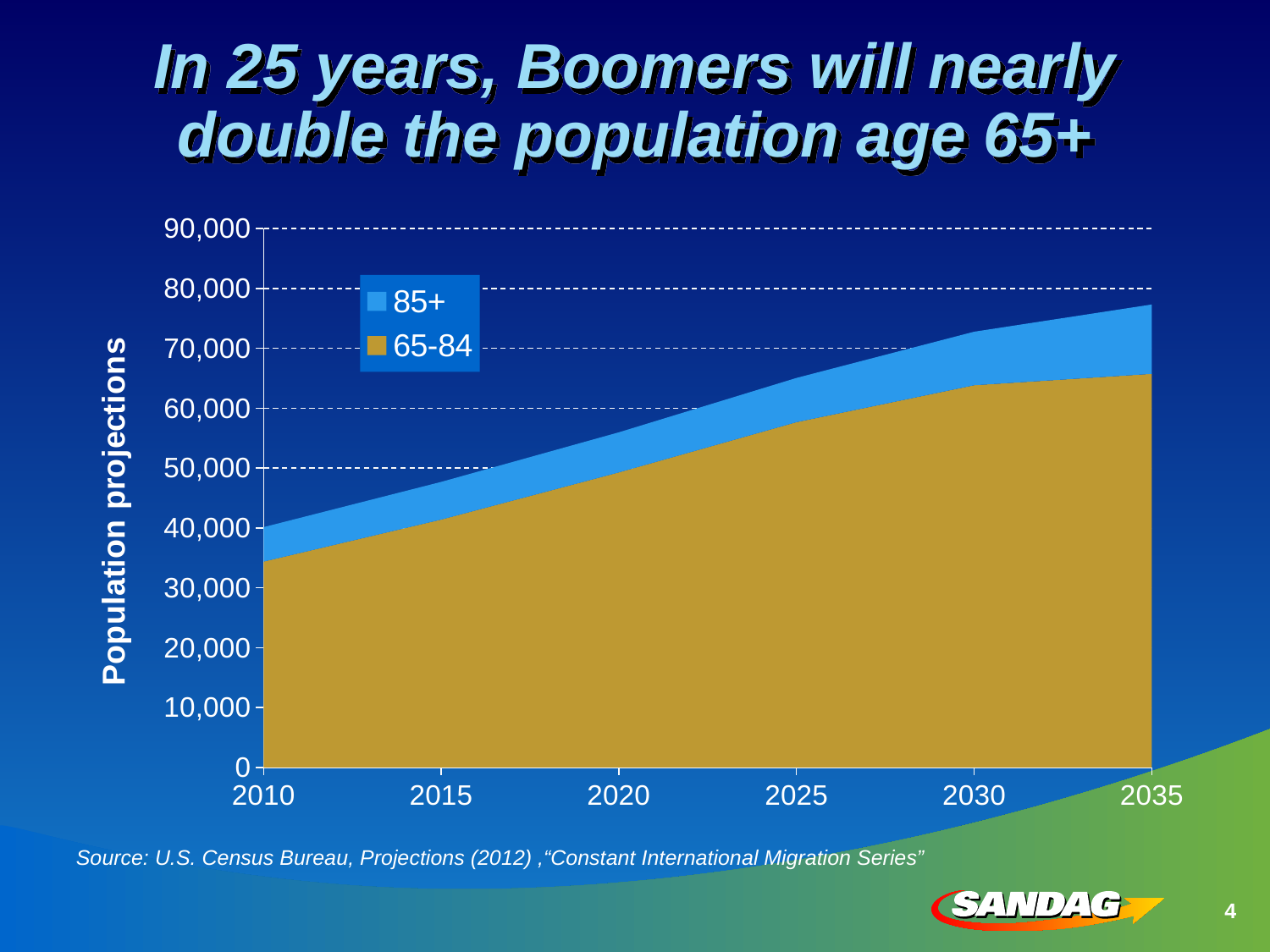
What is the label on the vertical axis? Population projections Which year shows the highest total population age 65+? 2035 How many year labels are shown along the x axis? 6 Is the value for the 65-84 series in 2030 greater or less than 60,000? greater What are the two series named in the legend? 85+ and 65-84 What kind of chart is shown on the slide? Area chart Does the total population age 65+ rise or fall from 2010 to 2035? Rise Is the value for the 65-84 series in 2010 greater or less than 40,000? less Which year shows the lowest total population age 65+? 2010 In 2035, which series is larger, 65-84 or 85+? 65-84 Is the total population age 65+ in 2035 greater or less than 70,000? greater How many series does the legend list? 2